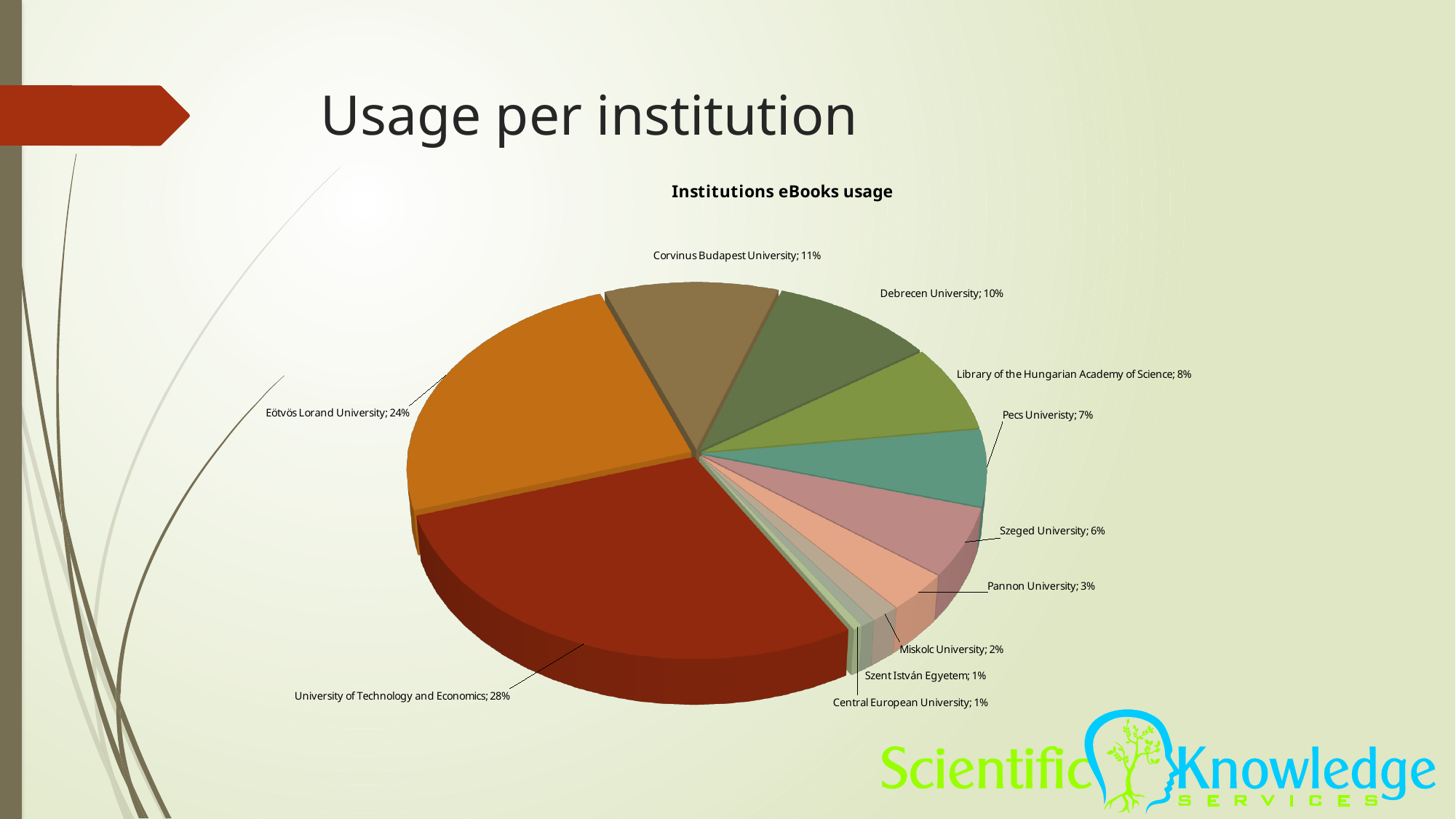
Which institution has the largest share of eBooks usage? University of Technology and Economics What share of eBooks usage does Miskolc University have? 2% What share of eBooks usage does Eötvös Lorand University have? 24% What is the title of the chart? Institutions eBooks usage What share of eBooks usage does the Library of the Hungarian Academy of Science have? 8% What is the combined share of Eötvös Lorand University and University of Technology and Economics? 52% What kind of chart is shown on the slide? pie chart What is the share of the largest slice in the pie? 28% How many institutions are shown in the pie chart? 11 What share of eBooks usage does Debrecen University have? 10% What is the difference in share between Corvinus Budapest University and Pecs Univeristy? 4% Which has a larger share, Szeged University or Pannon University? Szeged University